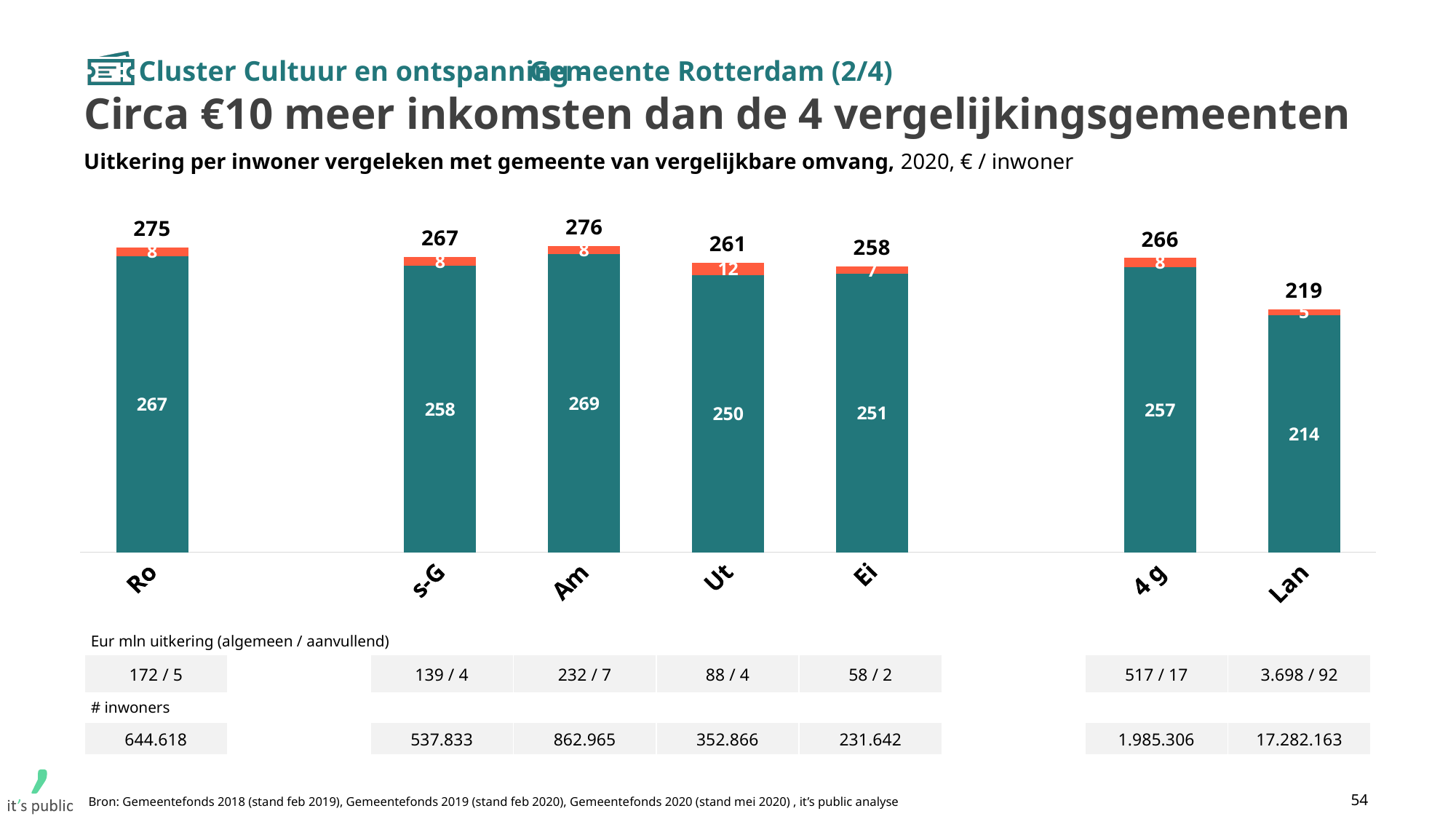
What is the value of the orange (upper) segment of the bar for Ut? 12 Which category has the lowest total value? Lan What is the difference between the teal segment of Ro and the teal segment of Lan? 53 How many bars are shown in the chart? 7 What is the total value shown above the bar for Ro? 275 What is the total value shown above the bar for Lan? 219 Which category has the highest total value? Am What kind of chart is shown on the slide? Stacked bar chart What is the difference between the total for Ro and the total for 4 g? 9 What is the value of the teal (lower) segment of the bar for s-G? 258 Which has a larger total, Ro or Ei? Ro What is the value of the teal (lower) segment of the bar for Am? 269